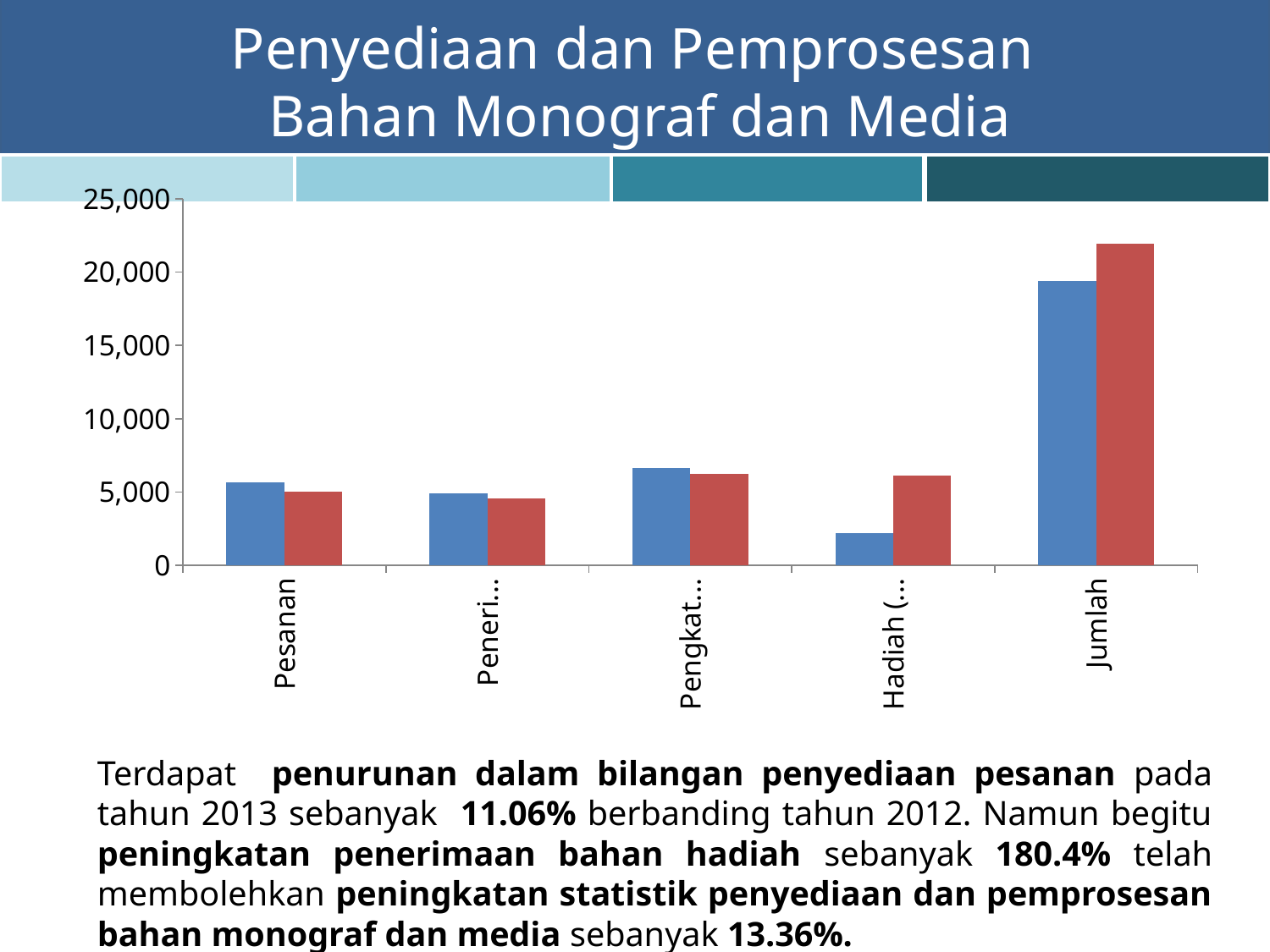
Which category has the shortest blue bar in the chart? Hadiah For Hadiah, which bar is taller, the blue one or the red one? red For Jumlah, which bar is taller, the blue one or the red one? red Is the value of the red bar for Jumlah greater or less than 20,000? greater What is the highest value shown on the y axis of the chart? 25,000 Is the value of the blue bar for Pesanan greater or less than 10,000? less Which category has the tallest bars in the chart? Jumlah What kind of chart is shown on the slide? bar chart How many categories are shown along the x axis of the chart? 5 Is the value of the blue bar for Jumlah greater or less than 15,000? greater How many bar series are plotted for each category in the chart? 2